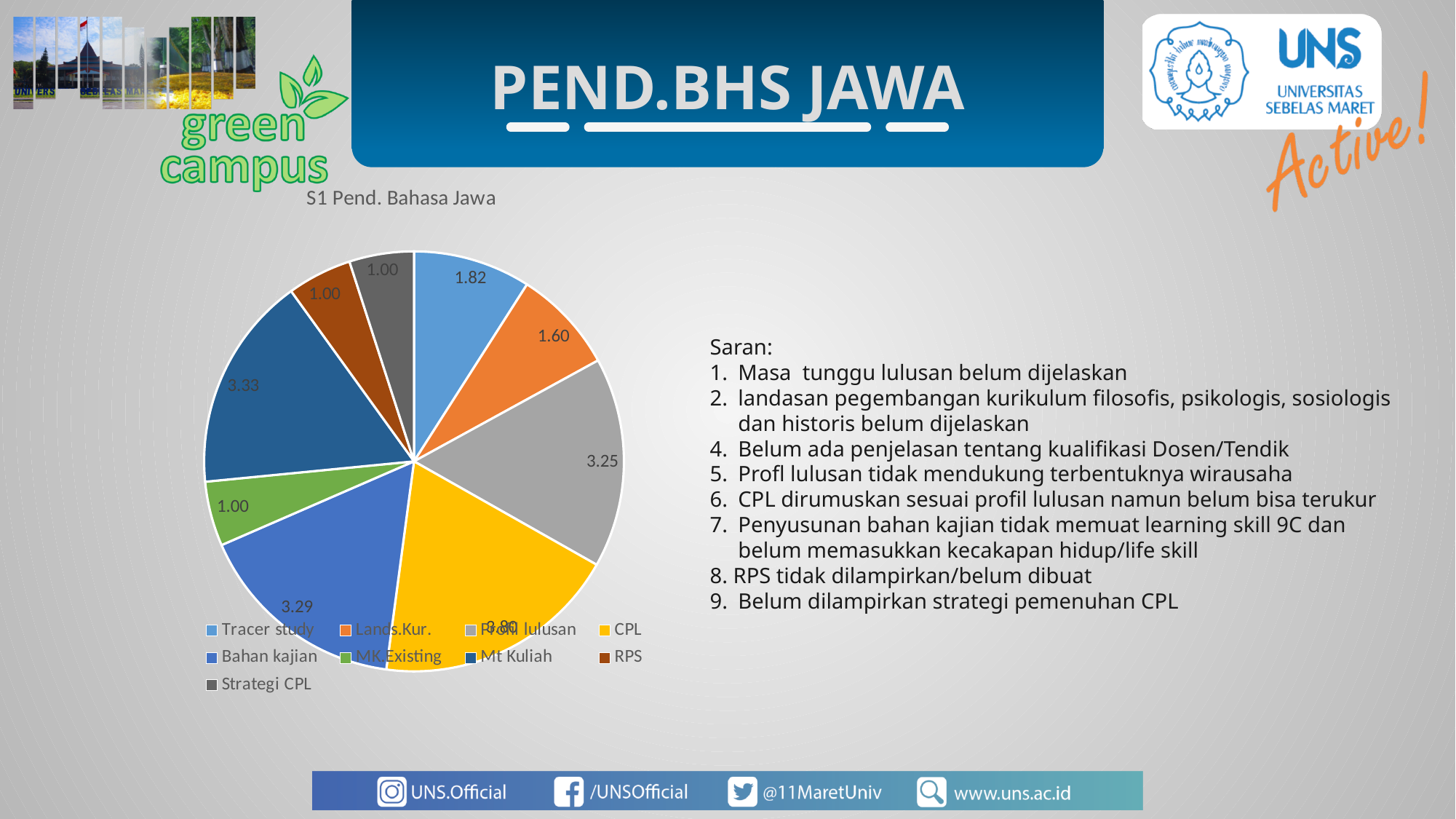
What type of chart is shown on the slide? Pie chart What is the value for Profil lulusan? 3.25 What is the value for Bahan kajian? 3.29 What is the value for Lands.Kur.? 1.60 What is the title of the chart? S1 Pend. Bahasa Jawa What is the value for Tracer study? 1.82 What is the difference between the values for Mt Kuliah and MK.Existing? 2.33 What is the value for Mt Kuliah? 3.33 Which colour represents CPL in the pie chart? Yellow What is the value for MK.Existing? 1.00 Which is larger, Tracer study or Lands.Kur.? Tracer study How many categories does the pie chart have? 9